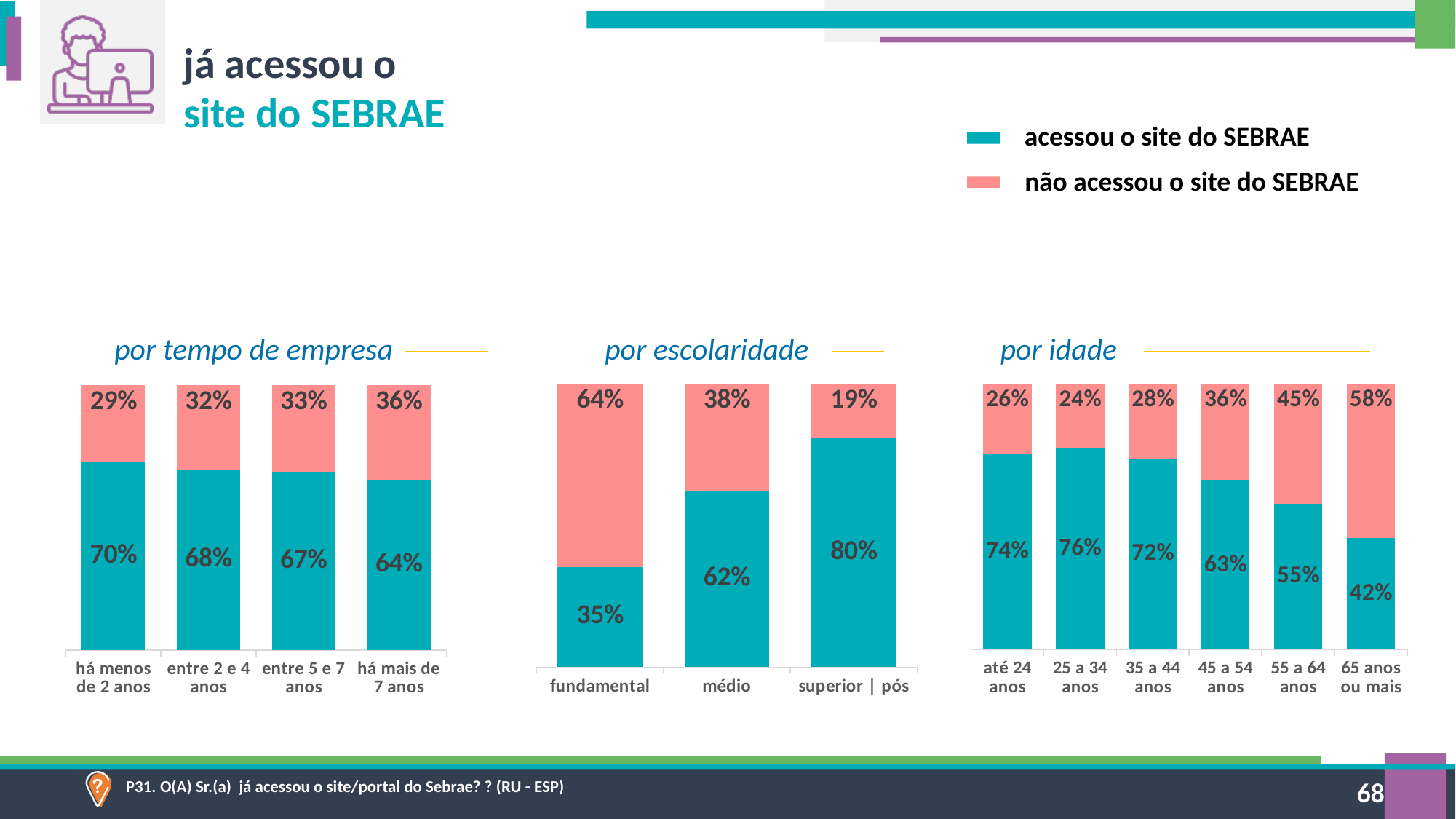
How many series does the legend list? 2 What type of chart is the 'por tempo de empresa' chart? stacked bar chart In the 'por tempo de empresa' chart, does the 'acessou o site do SEBRAE' value rise or fall as company age increases from left to right? fall In the 'por escolaridade' chart, which education level has the lowest 'acessou o site do SEBRAE' value? fundamental In the 'por idade' chart, what is the 'não acessou o site do SEBRAE' value for '65 anos ou mais'? 58% In the 'por idade' chart, what is the total of the stacked bar for '45 a 54 anos'? 99% How many categories are shown in the 'por idade' chart? 6 In the 'por idade' chart, which age group has the highest 'acessou o site do SEBRAE' value? 25 a 34 anos In the 'por tempo de empresa' chart, what is the 'acessou o site do SEBRAE' value for 'há mais de 7 anos'? 64% In the 'por tempo de empresa' chart, which is larger: the 'não acessou' value for 'há menos de 2 anos' or for 'há mais de 7 anos'? há mais de 7 anos In the 'por escolaridade' chart, what percentage of respondents with 'superior | pós' education accessed the SEBRAE site? 80% In the 'por escolaridade' chart, what is the difference between the 'acessou' values for 'superior | pós' and 'fundamental'? 45%